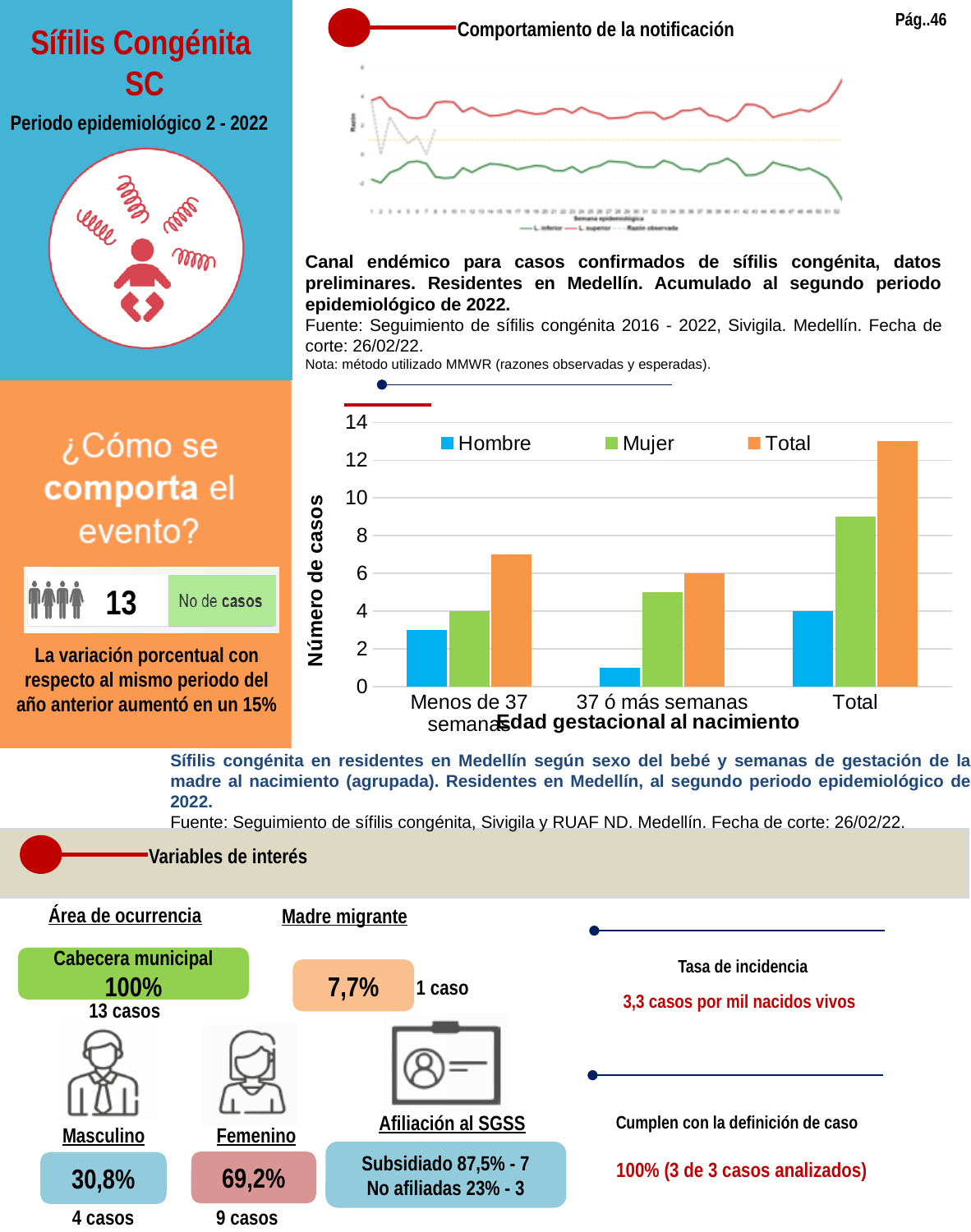
In the bar chart of cases by gestational age, how many series does the legend list? 3 In the bar chart of cases by gestational age, what is the value for Total in the '37 ó más semanas' category? 6 In the bar chart of cases by gestational age, which category has the lowest Hombre bar? 37 ó más semanas In the bar chart of cases by gestational age, which is larger in the '37 ó más semanas' category, Hombre or Mujer? Mujer What kind of chart is the chart titled 'Edad gestacional al nacimiento' with Hombre, Mujer and Total series? bar chart In the bar chart of cases by gestational age, how many categories are shown on the x axis? 3 In the bar chart of cases by gestational age, is the Total value for 'Menos de 37 semanas' greater or less than 6? greater In the bar chart of cases by gestational age, what is the value for Mujer in the 'Menos de 37 semanas' category? 4 In the bar chart of cases by gestational age, which category has the highest Mujer bar? Total In the bar chart of cases by gestational age, what is the value for Hombre in the 'Total' category? 4 What kind of chart is the chart under the heading 'Comportamiento de la notificación' at the top of the slide? line chart In the bar chart of cases by gestational age, what is the difference between the Total value for '37 ó más semanas' and the Mujer value for 'Menos de 37 semanas'? 2